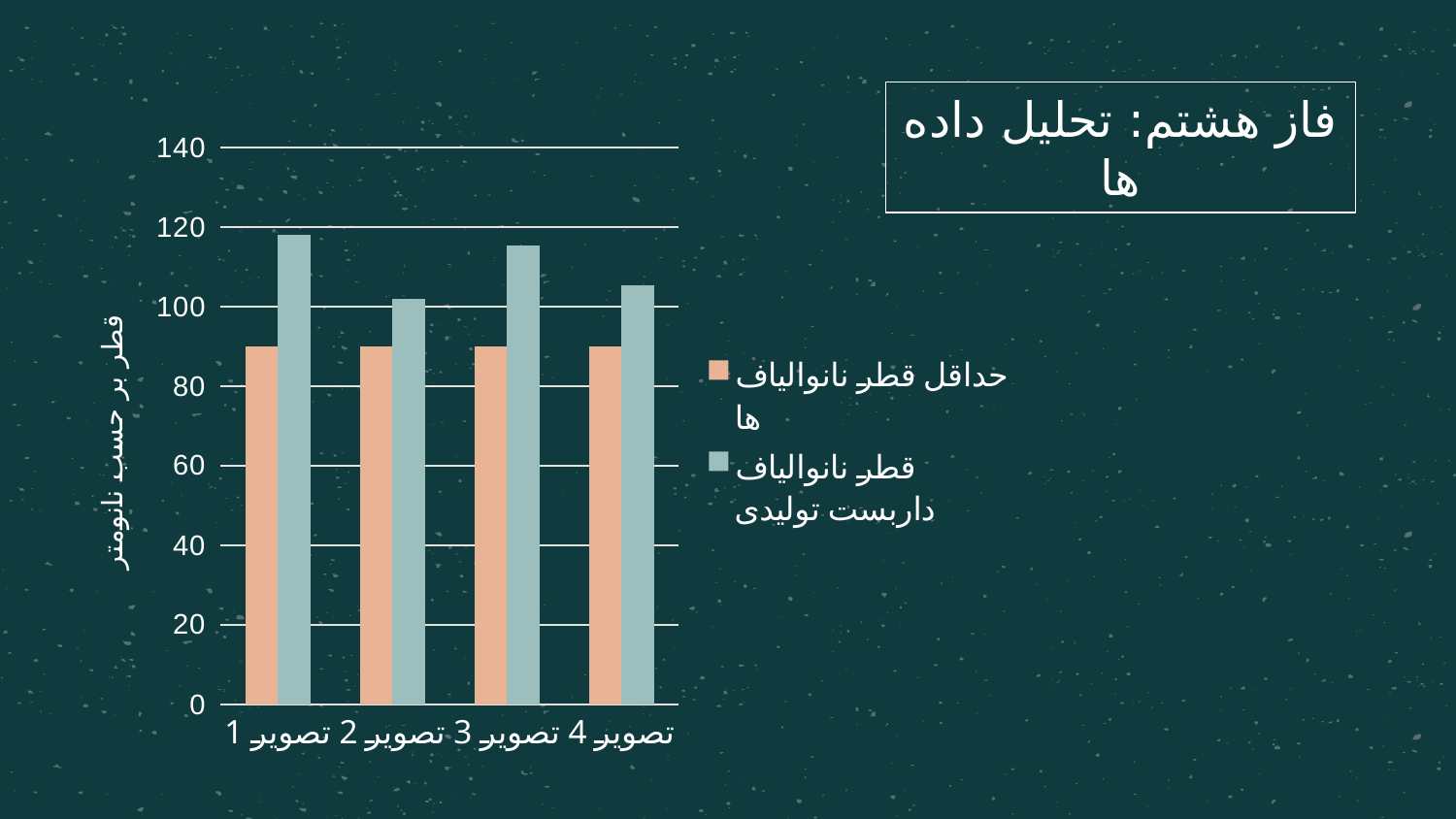
In the leftmost group of bars, is the value of the orange bar greater or less than 100? less In the leftmost group of bars, which series has the larger value? قطر نانوالیاف داربست تولیدی In the leftmost group of bars, is the value of the orange bar greater or less than 80? greater What kind of chart is shown on the slide? bar chart How many series does the legend list? 2 What is the label on the vertical axis of the chart? قطر بر حسب نانومتر What is the title of the slide containing the chart? فاز هشتم: تحلیل داده ها How many category groups are plotted along the x axis? 4 In the leftmost group of bars, is the value of the taller (teal) bar greater or less than 100? greater In the rightmost group of bars, which series has the smaller value? حداقل قطر نانوالیاف ها